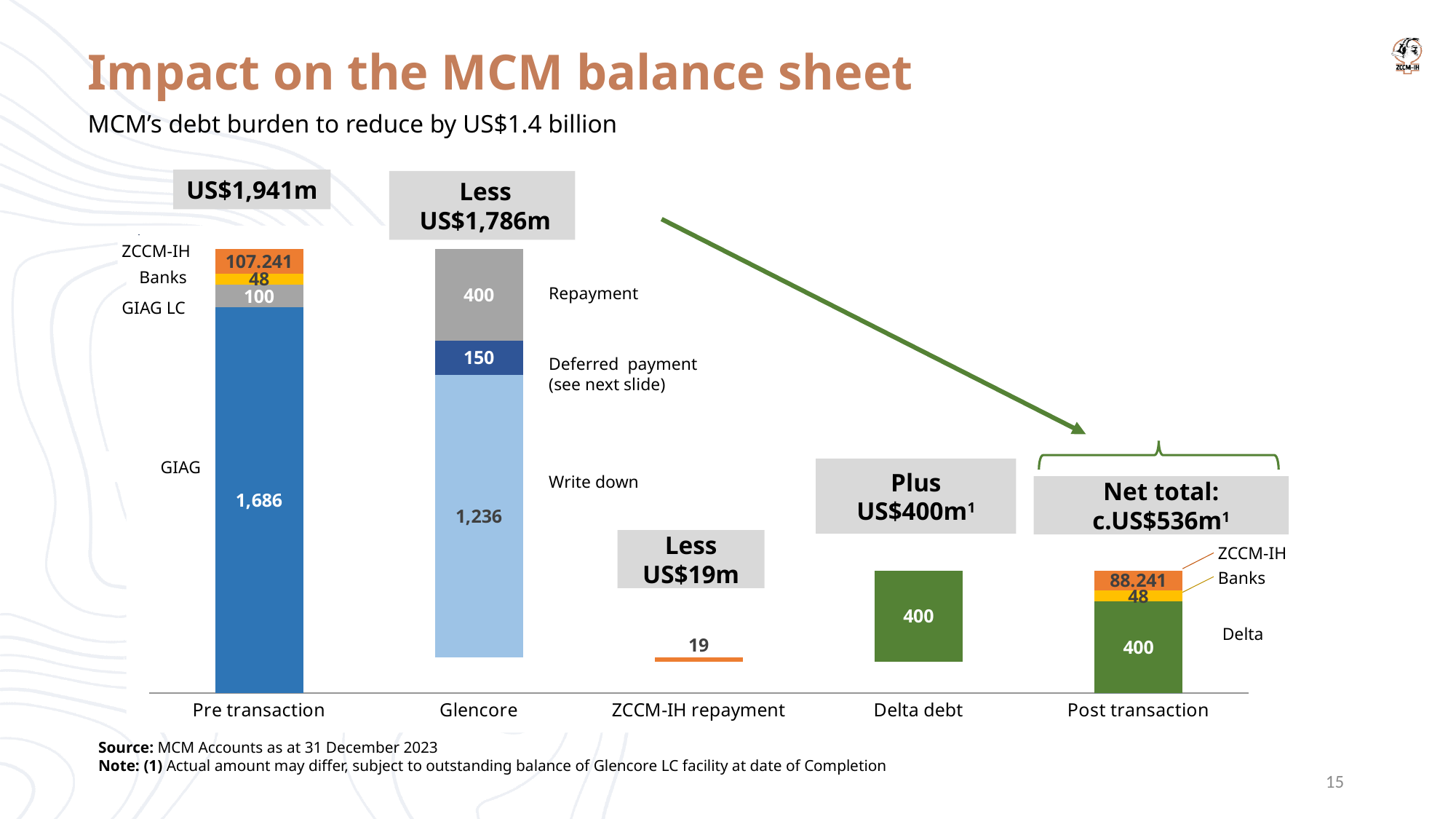
What is the difference between the ZCCM-IH segment in the Pre transaction bar (107.241) and the ZCCM-IH segment in the Post transaction bar (88.241)? 19 What is the value of the Banks segment in the Post transaction bar? 48 What is the value of the ZCCM-IH segment in the Pre transaction bar? 107.241 What is the total of the Pre transaction stacked bar as labelled on the slide? US$1,941m What is the value of the Write down segment in the Glencore bar? 1,236 Which category has the lowest bar in the chart? ZCCM-IH repayment What is the value of the GIAG segment in the Pre transaction bar? 1,686 What is the total of the Glencore stacked bar as labelled on the slide? US$1,786m How many categories are shown along the x axis of the chart? 5 What is the value shown for the ZCCM-IH repayment bar? 19 In the Glencore bar, which segment is larger: Repayment or Deferred payment? Repayment What kind of chart is shown on the slide? bar chart